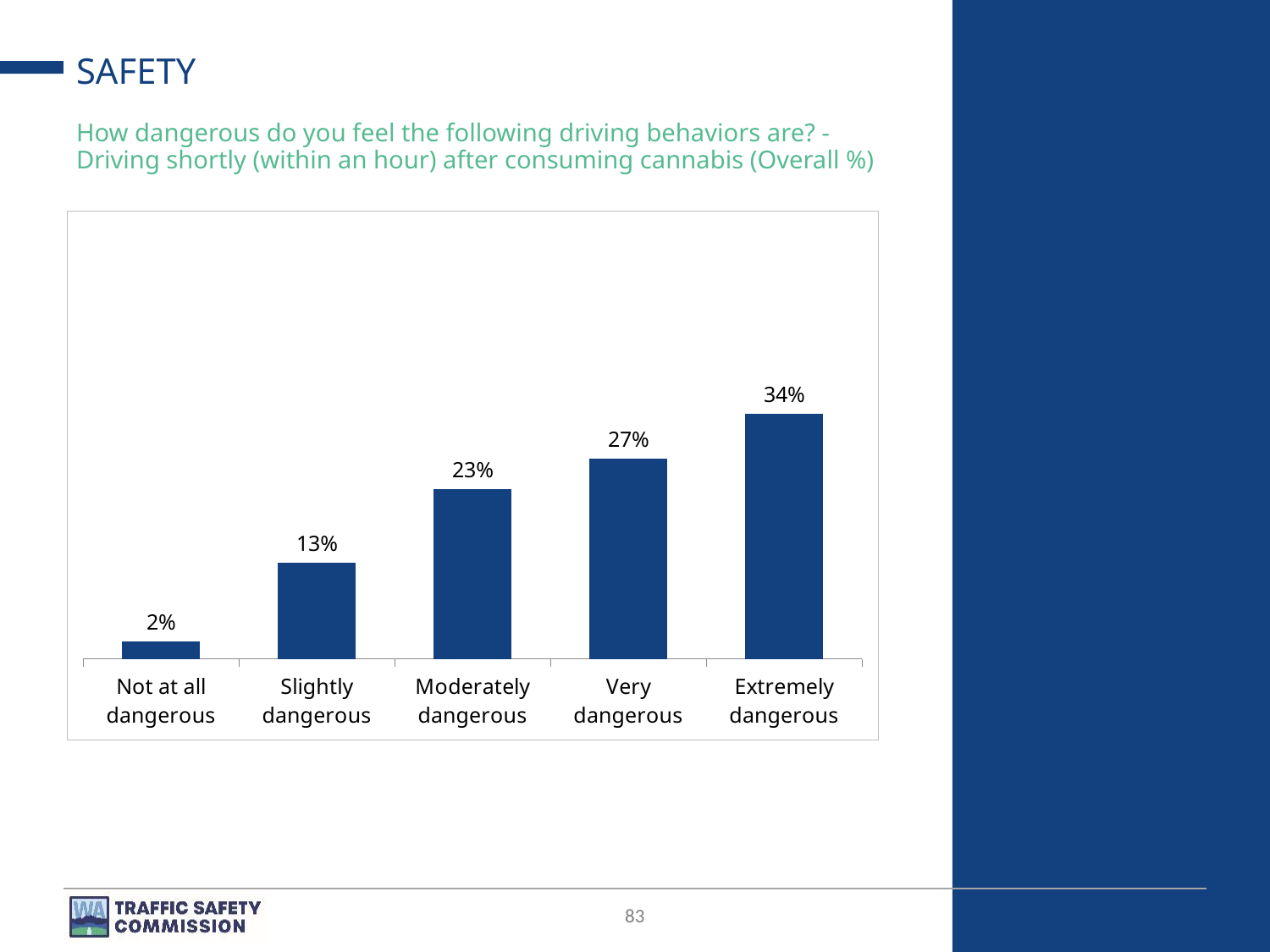
What percentage of respondents rated driving shortly after consuming cannabis as 'Extremely dangerous'? 34% Which category has the lowest value? Not at all dangerous Which is larger, the value for 'Very dangerous' or the value for 'Moderately dangerous'? Very dangerous What is the value shown for 'Moderately dangerous'? 23% Which category has the highest value? Extremely dangerous How many categories are shown on the x axis? 5 What driving behavior does the chart's question ask about? Driving shortly (within an hour) after consuming cannabis What percentage of respondents rated driving shortly after consuming cannabis as 'Not at all dangerous'? 2% What is the difference between the 'Extremely dangerous' and 'Very dangerous' values? 7% What kind of chart is shown on the slide? Bar chart Do the values rise or fall moving from left to right along the x axis? Rise What is the difference between the 'Slightly dangerous' and 'Not at all dangerous' values? 11%